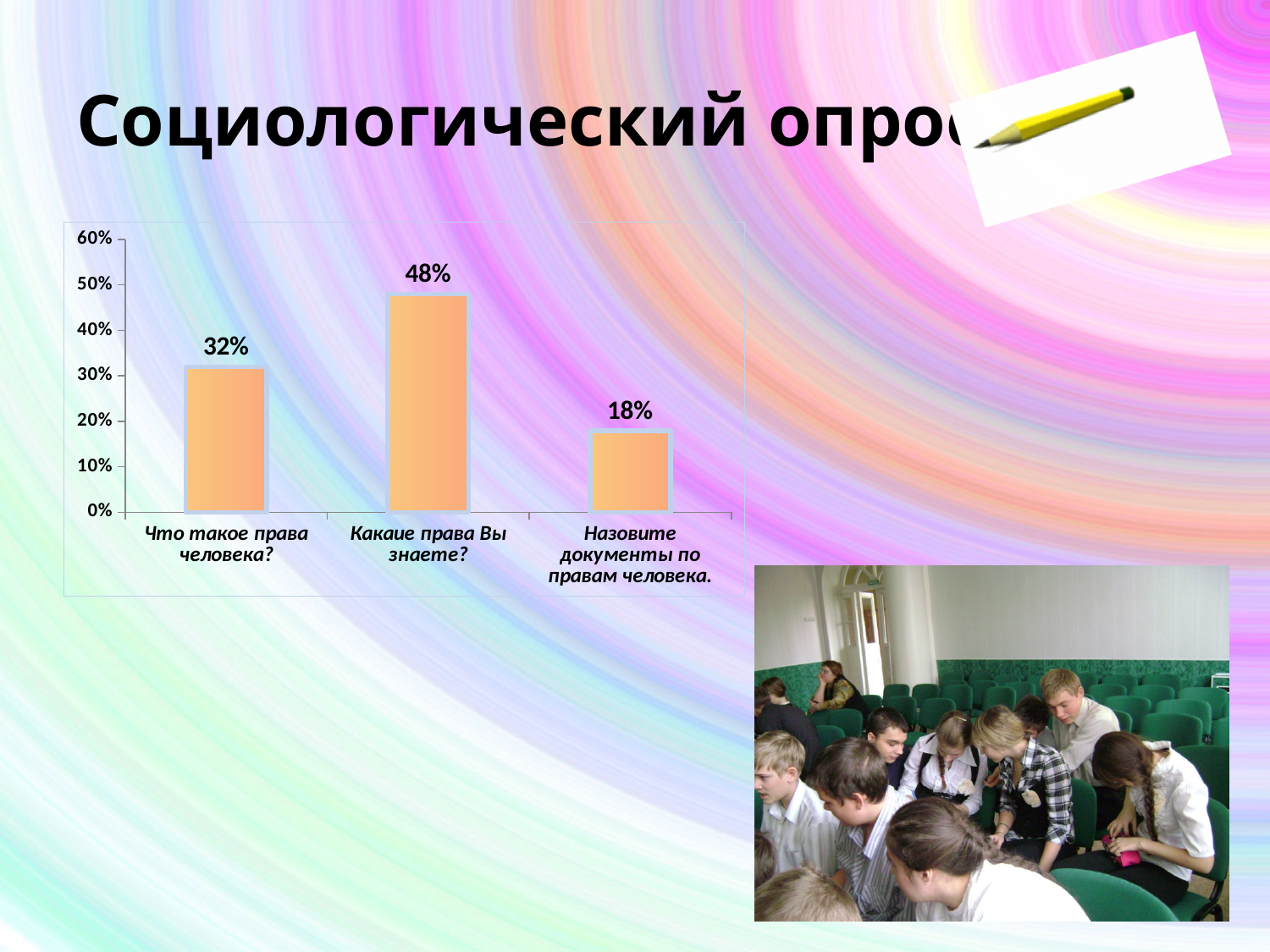
What is the value for "Какие права Вы знаете?"? 48% What is the difference between the values for "Какие права Вы знаете?" and "Что такое права человека?"? 16% What is the difference between the values for "Что такое права человека?" and "Назовите документы по правам человека."? 14% How many categories are shown in the chart? 3 Is the value for "Какие права Вы знаете?" greater or less than 40%? greater What is the value for "Назовите документы по правам человека."? 18% What kind of chart is shown on the slide? bar chart What is the value for "Что такое права человека?"? 32% Which category has the lowest value? Назовите документы по правам человека. What is the title of the slide containing the chart? Социологический опрос Which category has the highest value? Какаие права Вы знаете? Which is larger: the value for "Что такое права человека?" or for "Назовите документы по правам человека."? Что такое права человека?